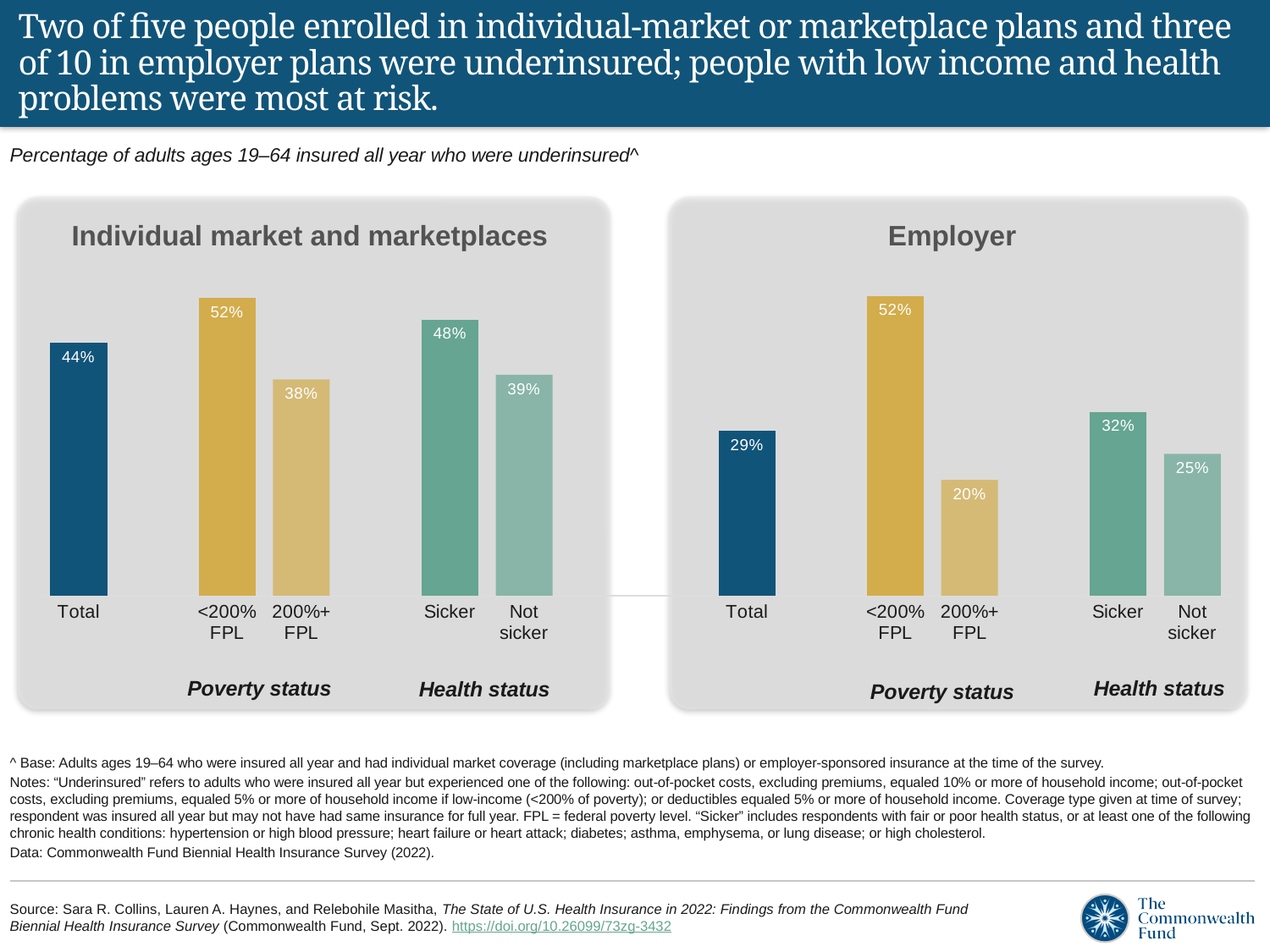
In the 'Employer' chart, which category has the lowest value? 200%+ FPL In the 'Individual market and marketplaces' chart, what is the value for Total? 44% In the 'Individual market and marketplaces' chart, which category has the highest value? <200% FPL Which is larger: the Sicker value in the 'Individual market and marketplaces' chart or the Sicker value in the 'Employer' chart? Individual market and marketplaces In the 'Individual market and marketplaces' chart, what is the value for Not sicker? 39% In the 'Employer' chart, what is the difference between the values for Sicker and Not sicker? 7 percentage points What are the titles of the two charts on the slide? Individual market and marketplaces; Employer In the 'Individual market and marketplaces' chart, what is the difference between the values for <200% FPL and 200%+ FPL? 14 percentage points How many bars are shown in the 'Employer' chart? 5 In the 'Employer' chart, what is the value for 200%+ FPL? 20% In the 'Employer' chart, what is the value for Total? 29% What type of chart is used on this slide? Bar chart